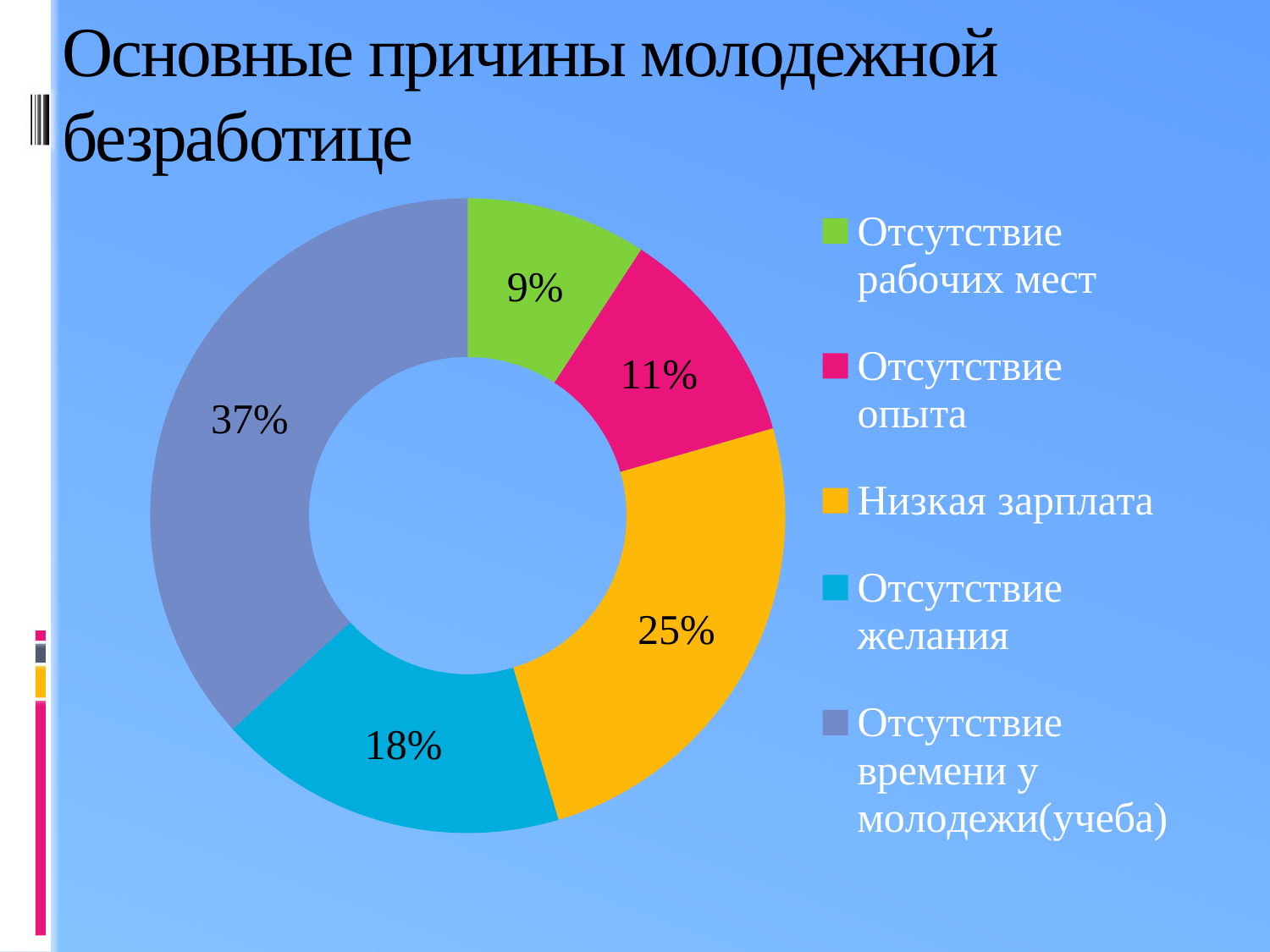
Which category has the smallest slice? Отсутствие рабочих мест What share of the chart does "Низкая зарплата" account for? 25% What is the value shown for "Отсутствие опыта"? 11% Which category has the largest slice? Отсутствие времени у молодежи(учеба) What colour is the slice for "Низкая зарплата"? Orange/yellow What is the value shown for "Отсутствие рабочих мест"? 9% What kind of chart is shown on the slide? Pie chart (doughnut) What is the value shown for "Отсутствие желания"? 18% What is the difference between the values for "Отсутствие времени у молодежи(учеба)" and "Низкая зарплата"? 12% Which is larger, the value for "Отсутствие желания" or the value for "Отсутствие опыта"? Отсутствие желания What is the difference between the values for "Отсутствие опыта" and "Отсутствие рабочих мест"? 2% How many categories are shown in the chart? 5